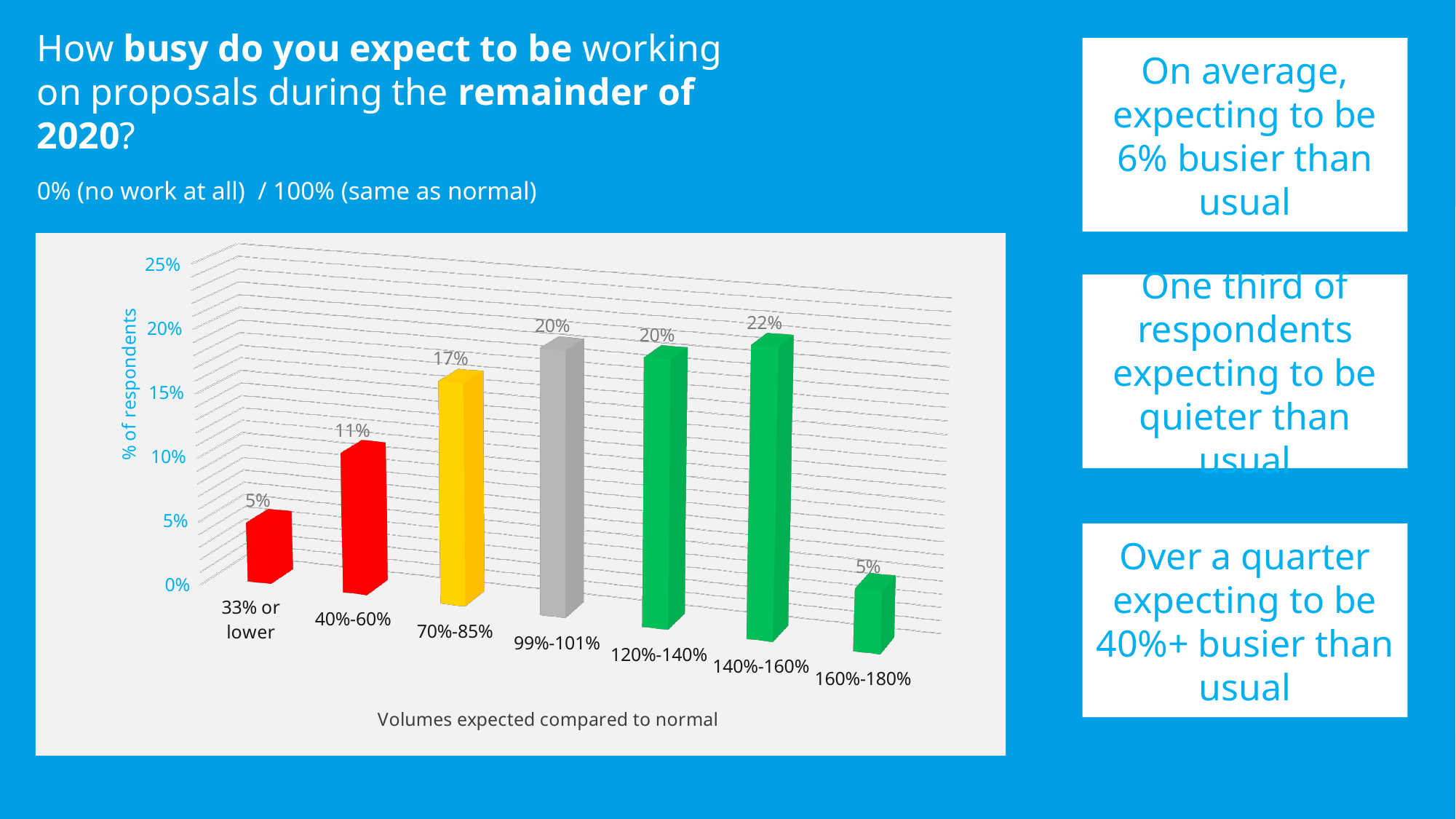
What is the difference in percentage of respondents between the 70%-85% category and the 33% or lower category? 12% What percentage of respondents expect volumes of 40%-60%? 11% Which category has the highest percentage of respondents? 140%-160% Which has a higher percentage of respondents, 70%-85% or 120%-140%? 120%-140% What kind of chart is shown on the slide? Bar chart What percentage of respondents expect volumes of 140%-160%? 22% What percentage of respondents expect volumes of 99%-101%? 20% Is the value for the 160%-180% category greater or less than 10%? less What is the difference in percentage of respondents between the 140%-160% category and the 40%-60% category? 11% What is the label of the x axis of the chart? Volumes expected compared to normal How many categories are shown on the x axis of the chart? 7 What percentage of respondents expect volumes of 70%-85%? 17%